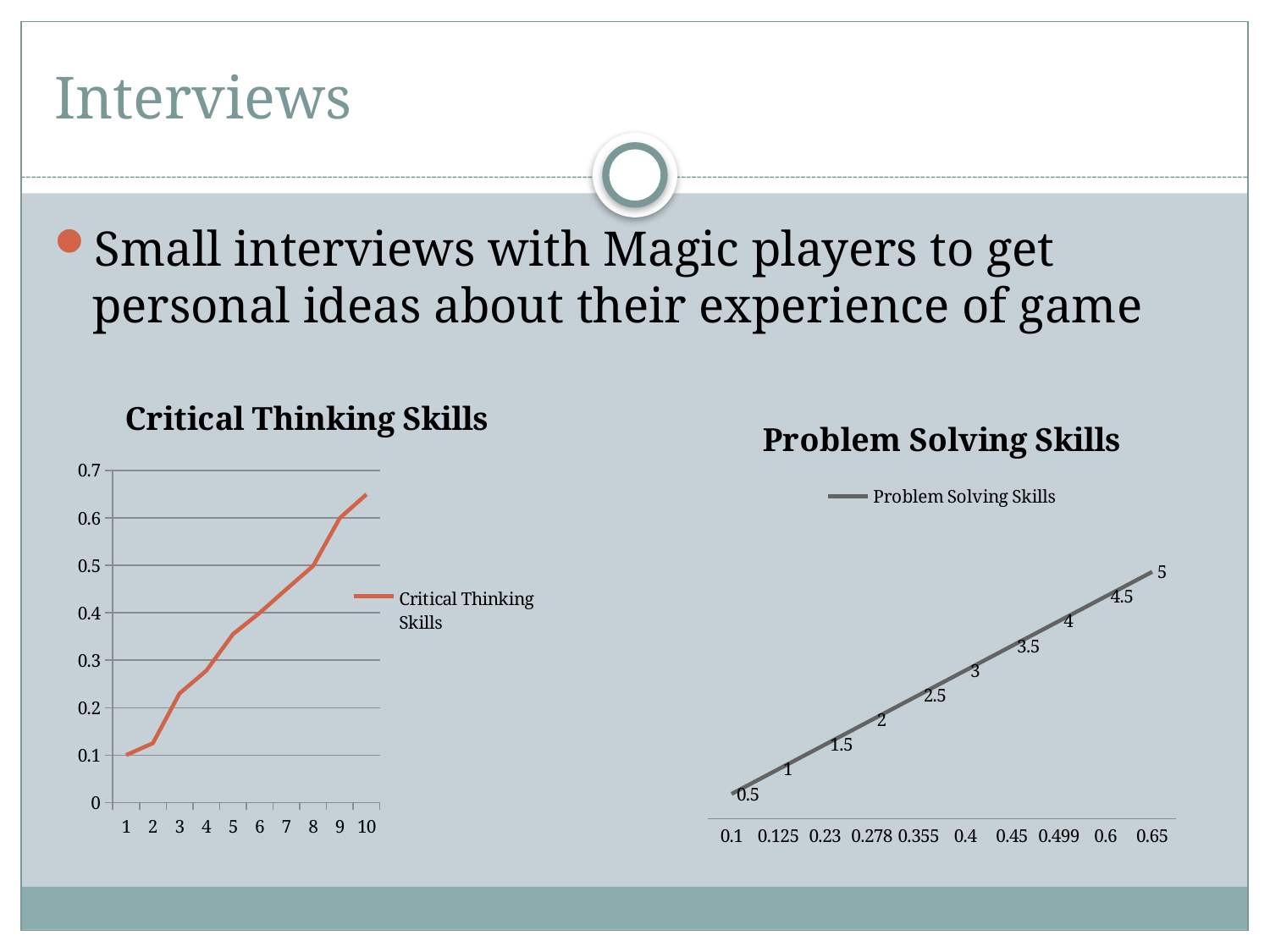
What kind of chart is the Critical Thinking Skills chart? line chart On the Problem Solving Skills chart, what is the value at the x category 0.65? 5 On the Critical Thinking Skills chart, is the value at x = 5 greater or less than 0.4? less On the Critical Thinking Skills chart, what is the value at x = 1? 0.1 How many data points are plotted on the Critical Thinking Skills chart? 10 On the Problem Solving Skills chart, which x category has the highest value? 0.65 On the Critical Thinking Skills chart, is the value at x = 10 greater or less than 0.6? greater How many series does the legend of the Problem Solving Skills chart list? 1 On the Critical Thinking Skills chart, do the values rise or fall from 1 to 10 along the x axis? rise On the Critical Thinking Skills chart, which x value has the lowest plotted value? 1 On the Problem Solving Skills chart, what is the difference between the values at 0.65 and 0.1? 4.5 On the Problem Solving Skills chart, what is the value at the x category 0.1? 0.5